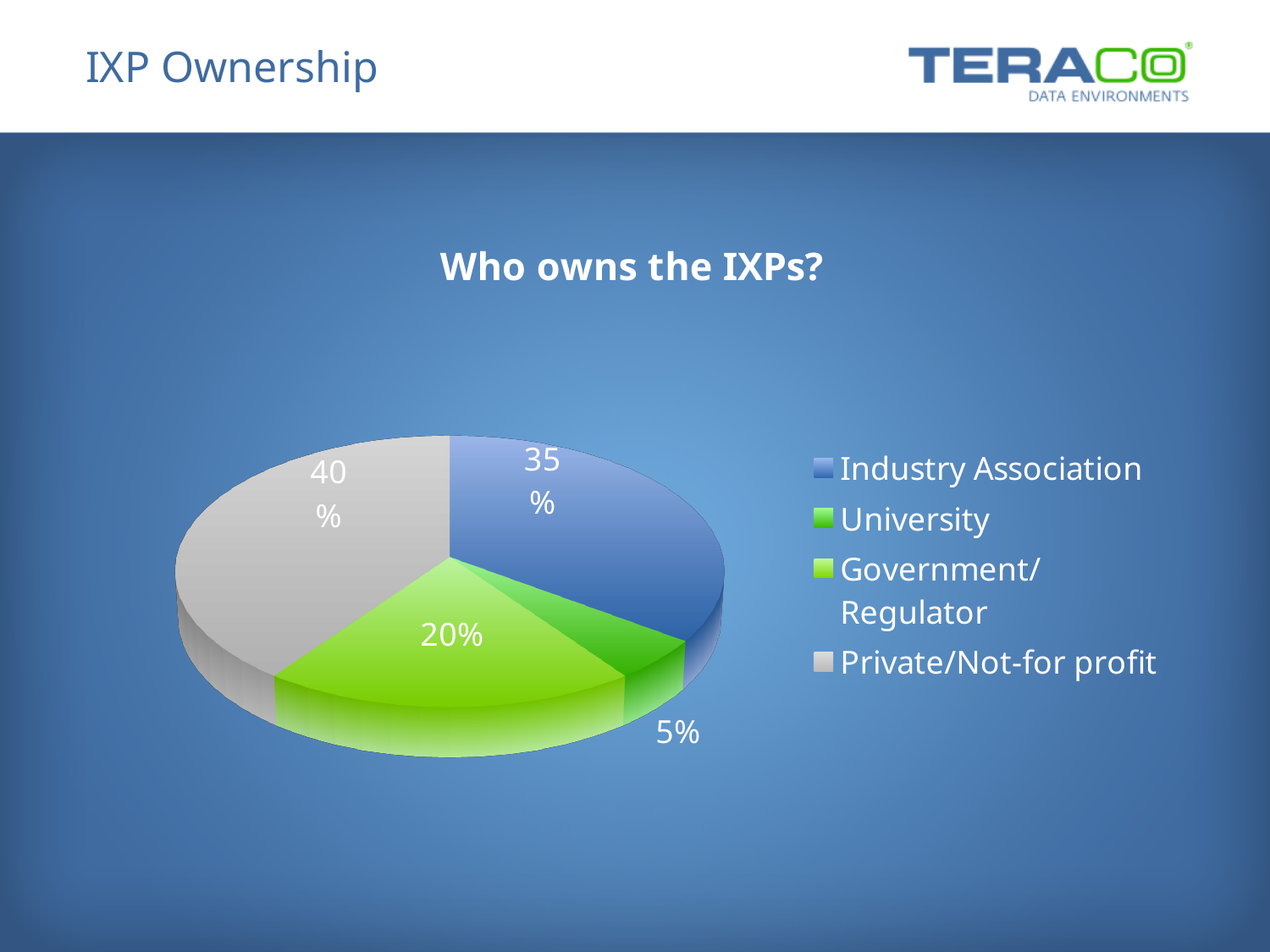
Which ownership category has the smallest share of the pie? University What share of IXPs is owned by Government/Regulator? 20% What type of chart is shown on the slide? pie chart What colour is the Industry Association slice? blue How many categories does the legend list? 4 What share of IXPs is owned by University? 5% What share of IXPs is owned by Private/Not-for profit? 40% What is the difference in percentage points between the Private/Not-for profit share and the Industry Association share? 5 What share of IXPs is owned by Industry Association? 35% What is the title of the chart? Who owns the IXPs? Which is larger, the Government/Regulator share or the University share? Government/Regulator Which ownership category has the largest share of the pie? Private/Not-for profit